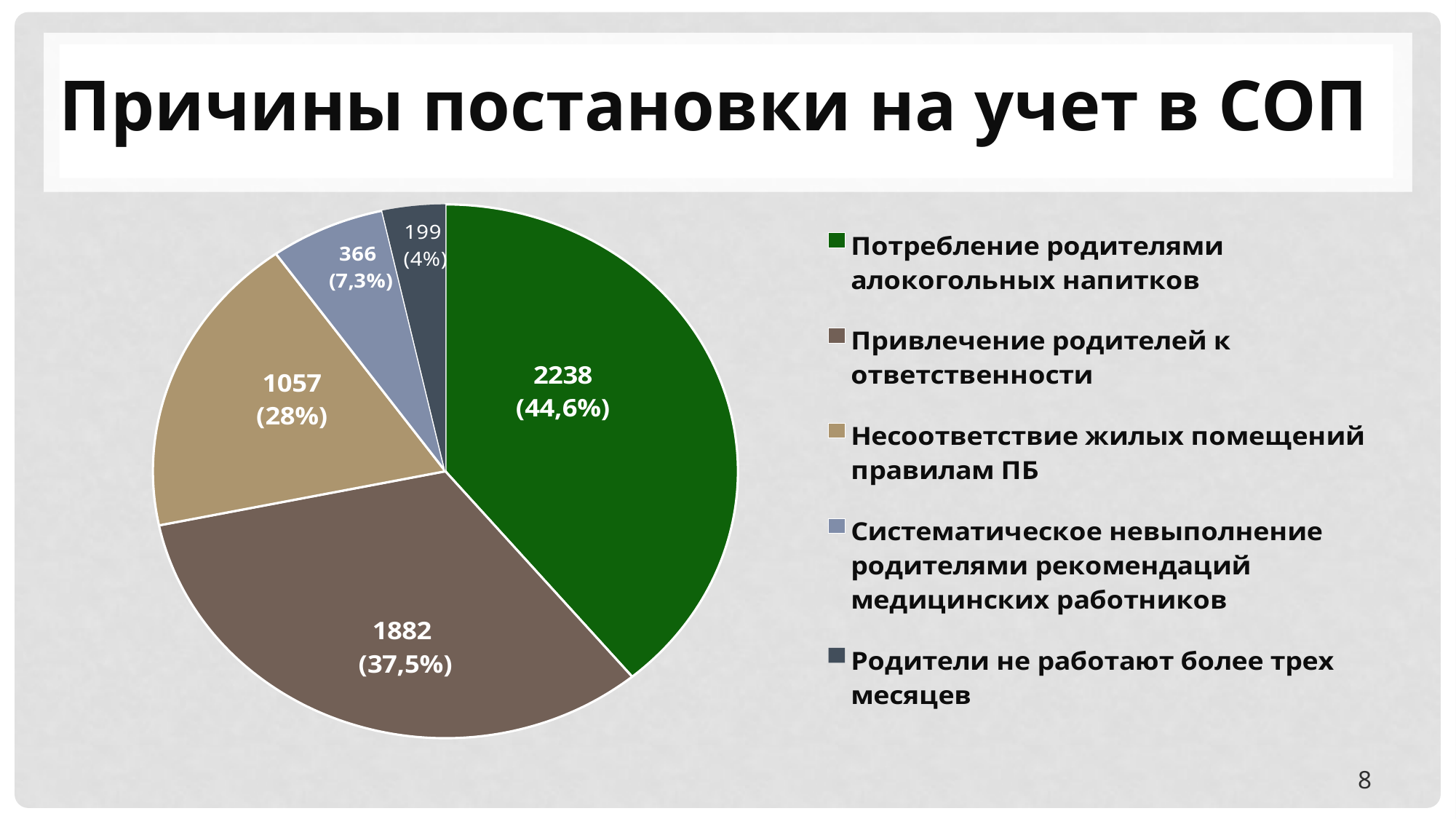
Какое значение указано для категории «Потребление родителями алокогольных напитков»? 2238 Какая категория имеет наибольшее значение? Потребление родителями алокогольных напитков Какая доля в процентах указана для категории «Потребление родителями алокогольных напитков»? 44,6% Какая категория имеет наименьшее значение? Родители не работают более трех месяцев Какой тип диаграммы показан на слайде? Круговая диаграмма Какое значение указано для категории «Привлечение родителей к ответственности»? 1882 Какое значение указано для категории «Родители не работают более трех месяцев»? 199 Какое значение указано для категории «Несоответствие жилых помещений правилам ПБ»? 1057 Какая доля в процентах указана для категории «Систематическое невыполнение родителями рекомендаций медицинских работников»? 7,3% На сколько значение категории «Потребление родителями алокогольных напитков» больше значения категории «Привлечение родителей к ответственности»? 356 Какая категория больше: «Несоответствие жилых помещений правилам ПБ» или «Систематическое невыполнение родителями рекомендаций медицинских работников»? Несоответствие жилых помещений правилам ПБ Сколько категорий (секторов) показано на круговой диаграмме? 5